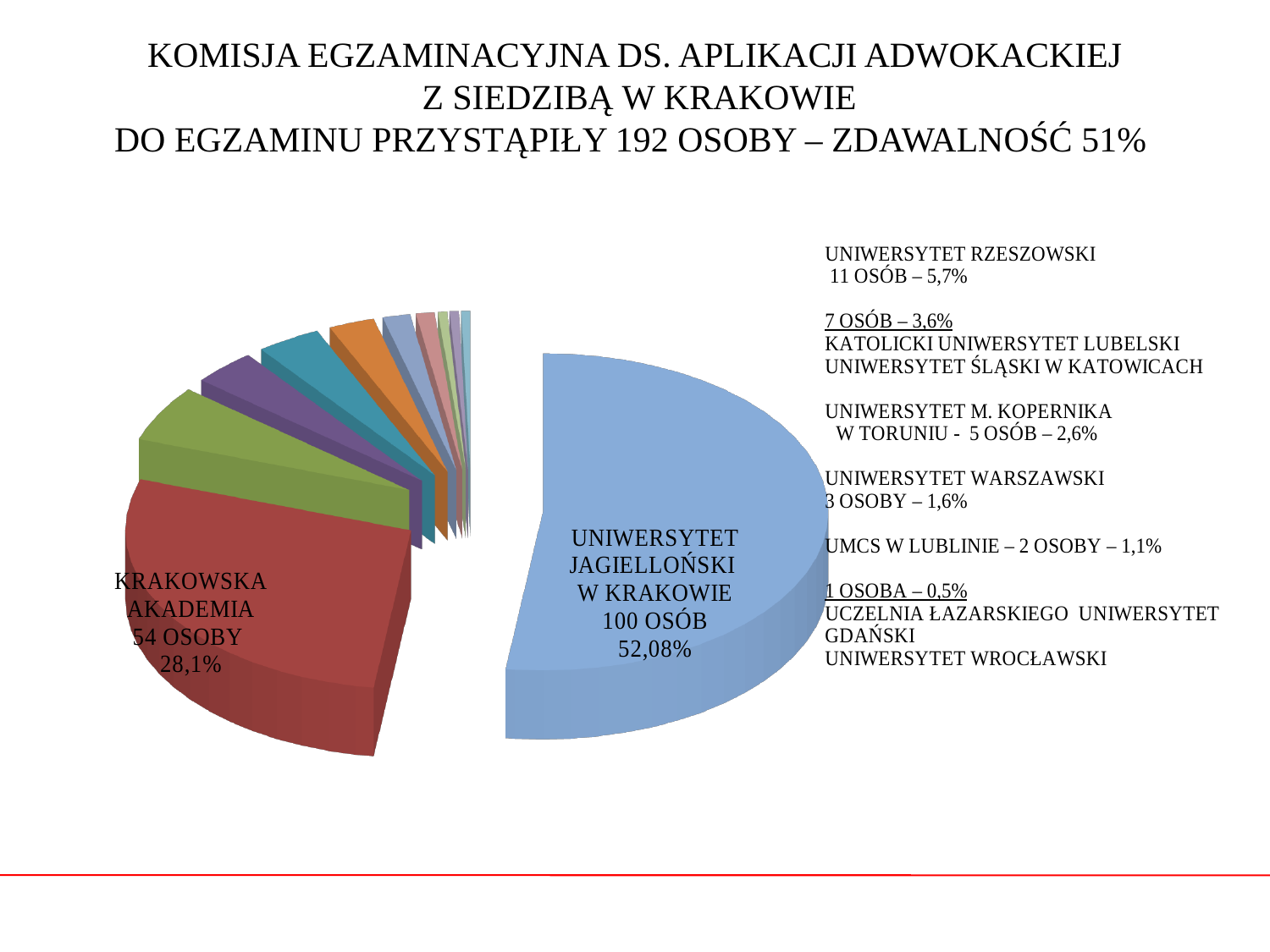
Which institution has the largest slice of the pie? Uniwersytet Jagielloński w Krakowie How many people from Krakowska Akademia are shown on the chart? 54 OSOBY What kind of chart is shown on the slide? pie chart What share of the pie does Uniwersytet Jagielloński w Krakowie represent? 52,08% How many people from UMCS w Lublinie are shown on the chart? 2 OSOBY What percentage share is labelled for Krakowska Akademia? 28,1% Which has more people: Uniwersytet Rzeszowski or Uniwersytet M. Kopernika w Toruniu? Uniwersytet Rzeszowski According to the slide title, how many people took the exam in total? 192 How many people from Uniwersytet Jagielloński w Krakowie took the exam according to the chart? 100 OSÓB How many people from Uniwersytet Rzeszowski are shown? 11 OSÓB What is the difference in the number of people between Uniwersytet Jagielloński w Krakowie and Krakowska Akademia? 46 What percentage share is given for Uniwersytet Warszawski? 1,6%